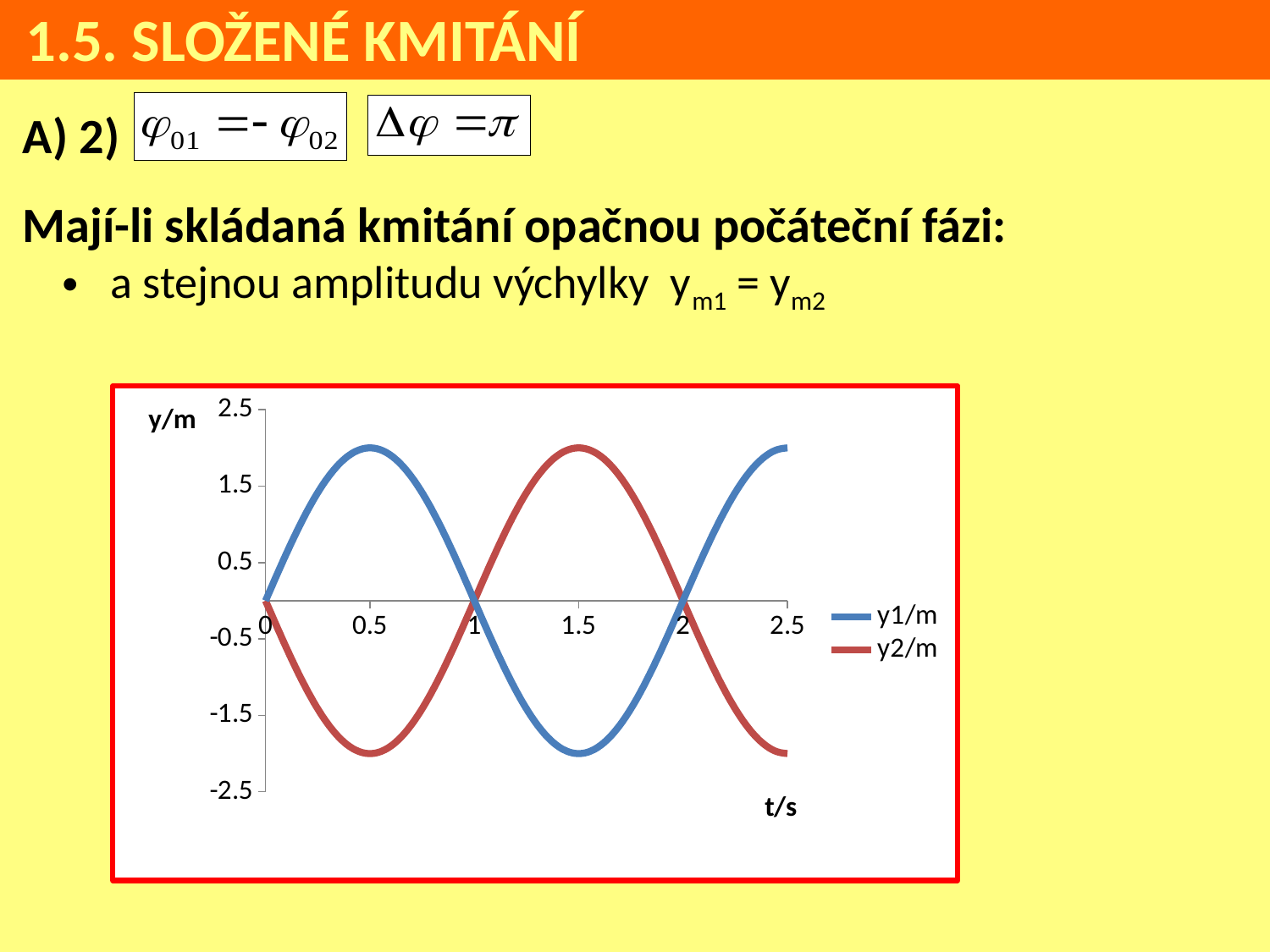
Is the value of y2/m at t = 1.5 greater or less than 1.5? greater Is the value of y2/m at t = 0.5 greater or less than -1.5? less What kind of chart is shown on the slide? line chart At t = 1.5, which series has the larger value, y1/m or y2/m? y2/m How many series does the chart legend list? 2 At t = 0.5, which series has the larger value, y1/m or y2/m? y1/m What are the two series names listed in the chart legend? y1/m and y2/m Does the y2/m curve rise or fall between t = 0.5 and t = 1.5? rise Is the value of y1/m at t = 0.5 greater or less than 1.5? greater What label is shown on the horizontal axis of the chart? t/s Does the y1/m curve rise or fall between t = 0 and t = 0.5? rise